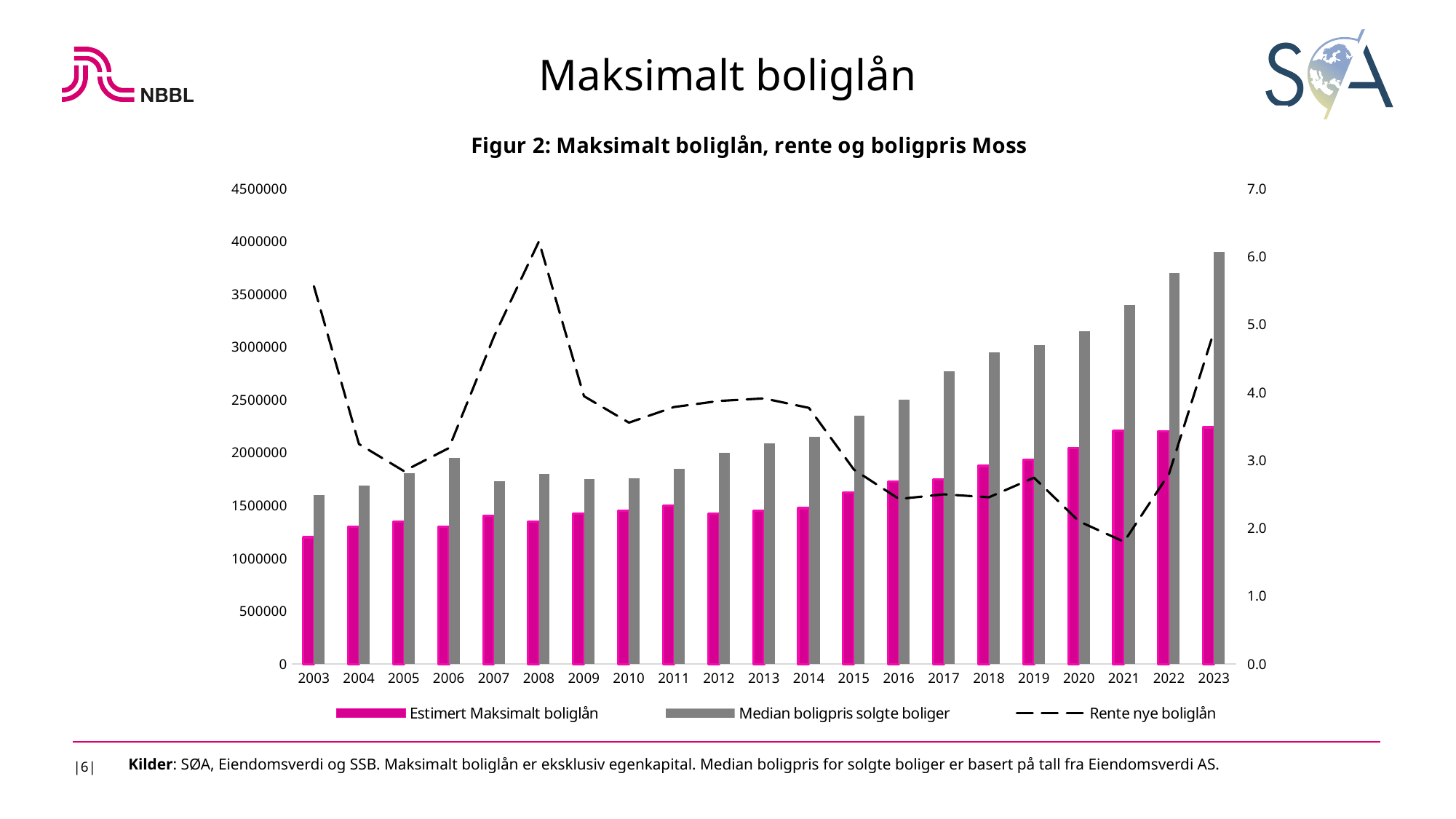
Is the value for Median boligpris solgte boliger in 2023 greater or less than 3500000? greater What kind of chart is shown on the slide? Combined bar and line chart In which year does Rente nye boliglån reach its highest value? 2008 Is the value for Rente nye boliglån in 2021 greater or less than 3.0? less In which year is Median boligpris solgte boliger highest? 2023 What is the title of the chart on the slide? Figur 2: Maksimalt boliglån, rente og boligpris Moss Is the value for Estimert Maksimalt boliglån in 2003 greater or less than 1500000? less Which series is drawn as a dashed line? Rente nye boliglån In which year is Estimert Maksimalt boliglån lowest? 2003 How many series does the chart's legend list? 3 Does Median boligpris solgte boliger generally rise or fall from 2003 to 2023? rise How many years are shown on the x axis of the chart? 21